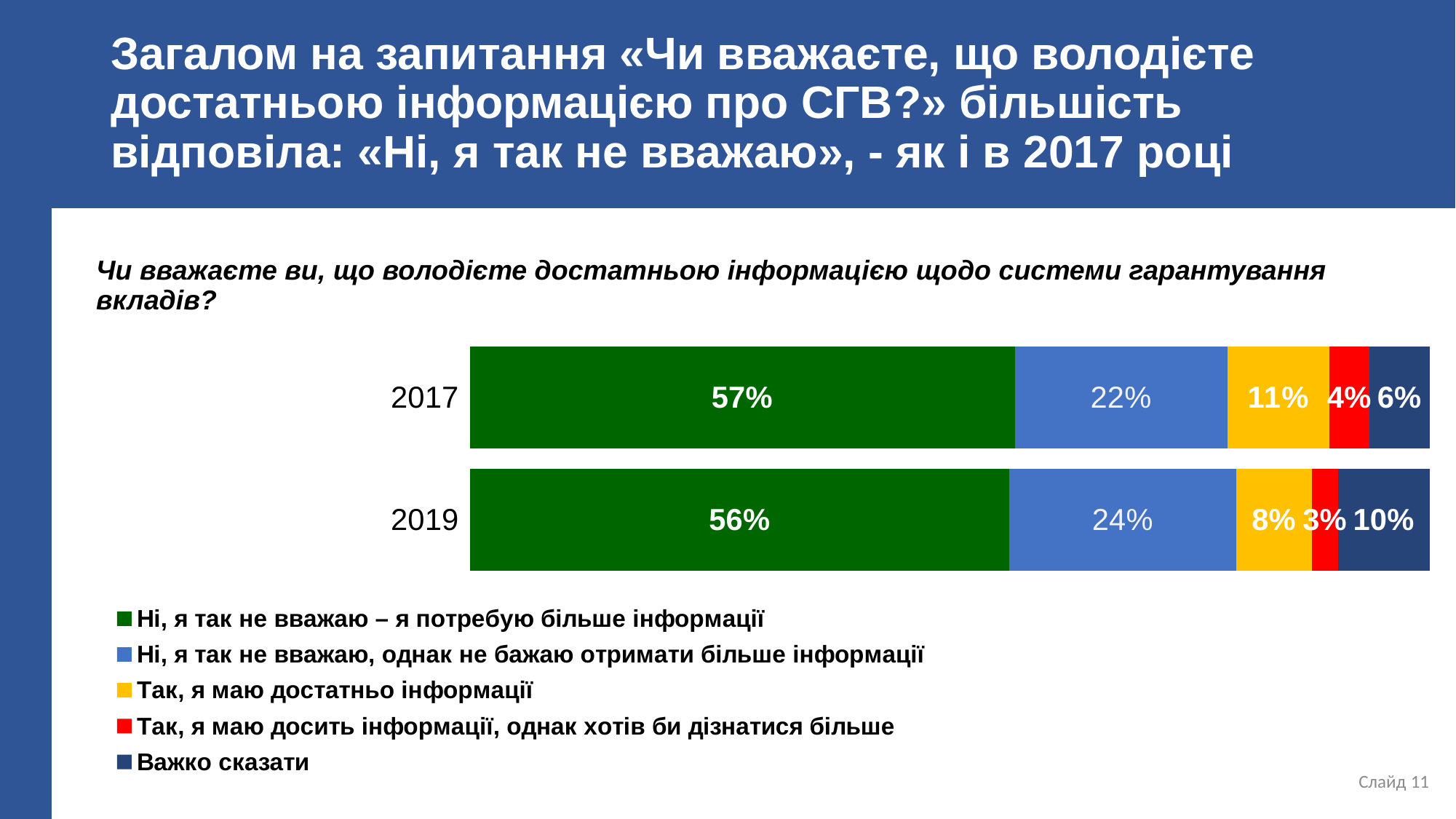
Which year has the larger value for "Так, я маю достатньо інформації", 2017 or 2019? 2017 Which series has the largest value in the 2019 bar? Ні, я так не вважаю – я потребую більше інформації How many series does the legend list? 5 Which series has the smallest value in the 2017 bar? Так, я маю досить інформації, однак хотів би дізнатися більше What kind of chart is shown on the slide? stacked bar chart What is the value for "Важко сказати" in 2019? 10% What is the difference between the "Важко сказати" values for 2019 and 2017? 4% What is the value for "Так, я маю досить інформації, однак хотів би дізнатися більше" in 2019? 3% What is the value for "Ні, я так не вважаю, однак не бажаю отримати більше інформації" in 2019? 24% What is the value for "Так, я маю достатньо інформації" in 2017? 11% What is the value for "Ні, я так не вважаю – я потребую більше інформації" in 2017? 57% How many categories (years) are plotted on the chart? 2